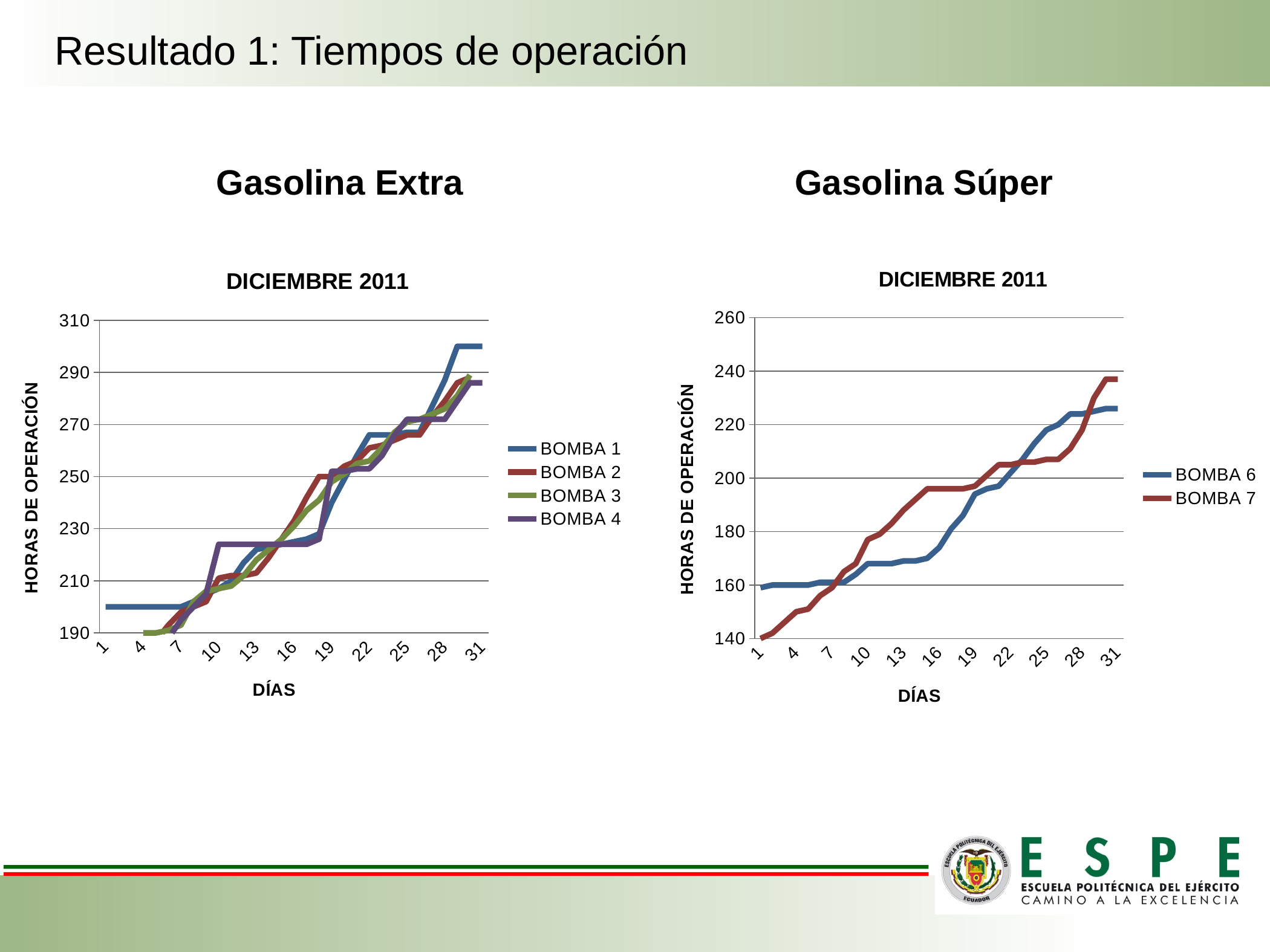
What kind of chart is the Gasolina Extra chart? line chart In the Gasolina Extra chart, which series has the highest value on day 31? BOMBA 1 In the Gasolina Súper chart, do the values for BOMBA 7 rise or fall from day 1 to day 31? rise In the Gasolina Extra chart, do the values for BOMBA 1 rise or fall across the days? rise In the Gasolina Súper chart, is the value for BOMBA 7 on day 31 greater or less than 220? greater In the Gasolina Súper chart, which series has the higher value on day 31, BOMBA 6 or BOMBA 7? BOMBA 7 In the Gasolina Súper chart, is the value for BOMBA 7 on day 1 greater or less than 160? less How many series does the legend of the Gasolina Extra chart list? 4 What is the y-axis label of the Gasolina Súper chart? HORAS DE OPERACIÓN In the Gasolina Súper chart, which series has the higher value on day 1, BOMBA 6 or BOMBA 7? BOMBA 6 In the Gasolina Extra chart, is the value for BOMBA 1 on day 31 greater or less than 290? greater How many series does the legend of the Gasolina Súper chart list? 2